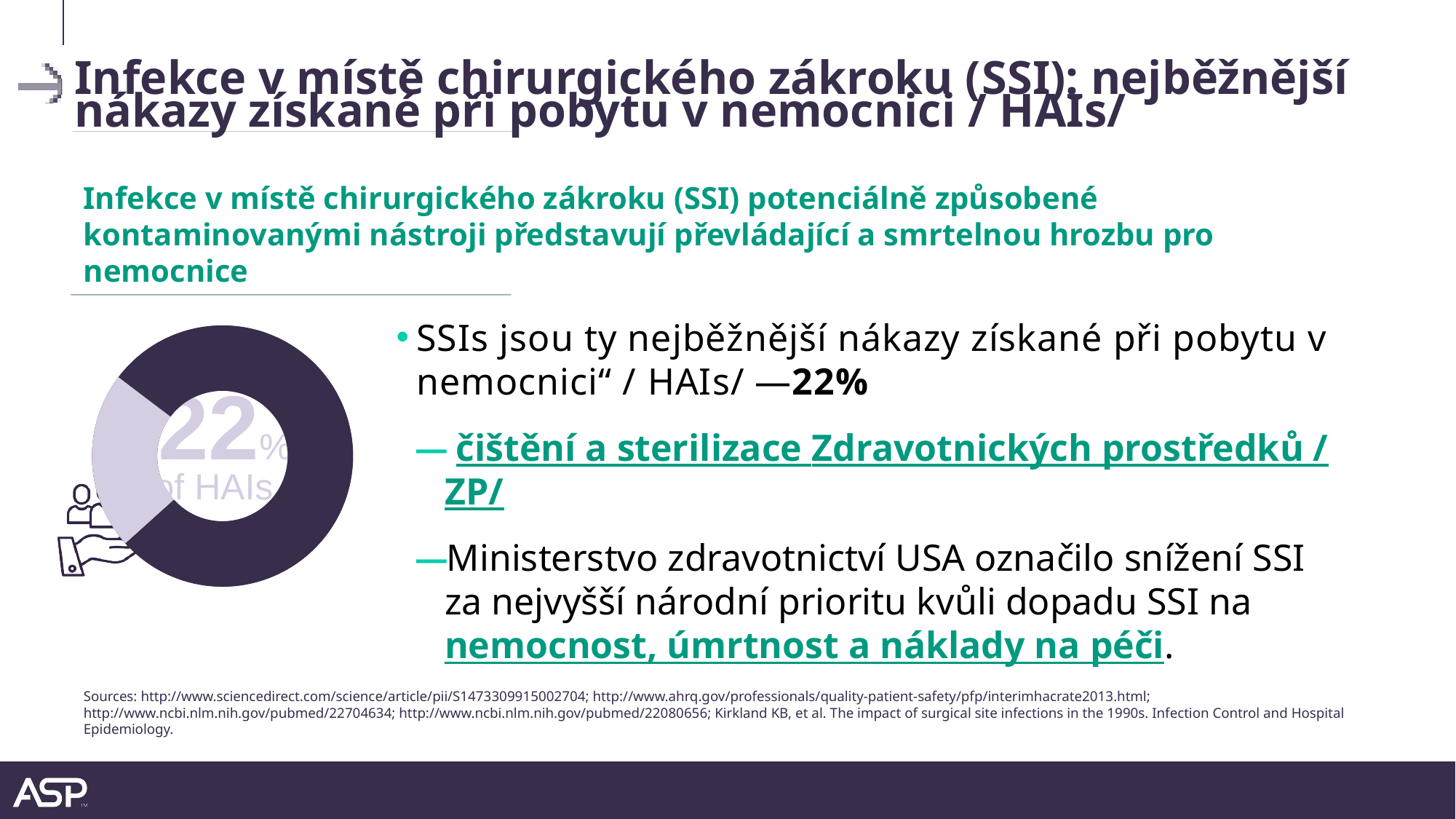
According to the donut chart, what share of HAIs do SSIs represent? 22% Which segment of the donut chart is larger, the light grey one or the dark purple one? The dark purple one What percentage is printed in the centre of the donut chart? 22% What share of HAIs is represented by the dark purple segment of the donut chart? 78% Is the share shown by the light grey segment of the donut chart greater or less than 50%? less What kind of chart is shown on the left of the slide? Donut (pie) chart What text appears below the percentage in the centre of the donut chart? of HAIs How many segments does the donut chart have? 2